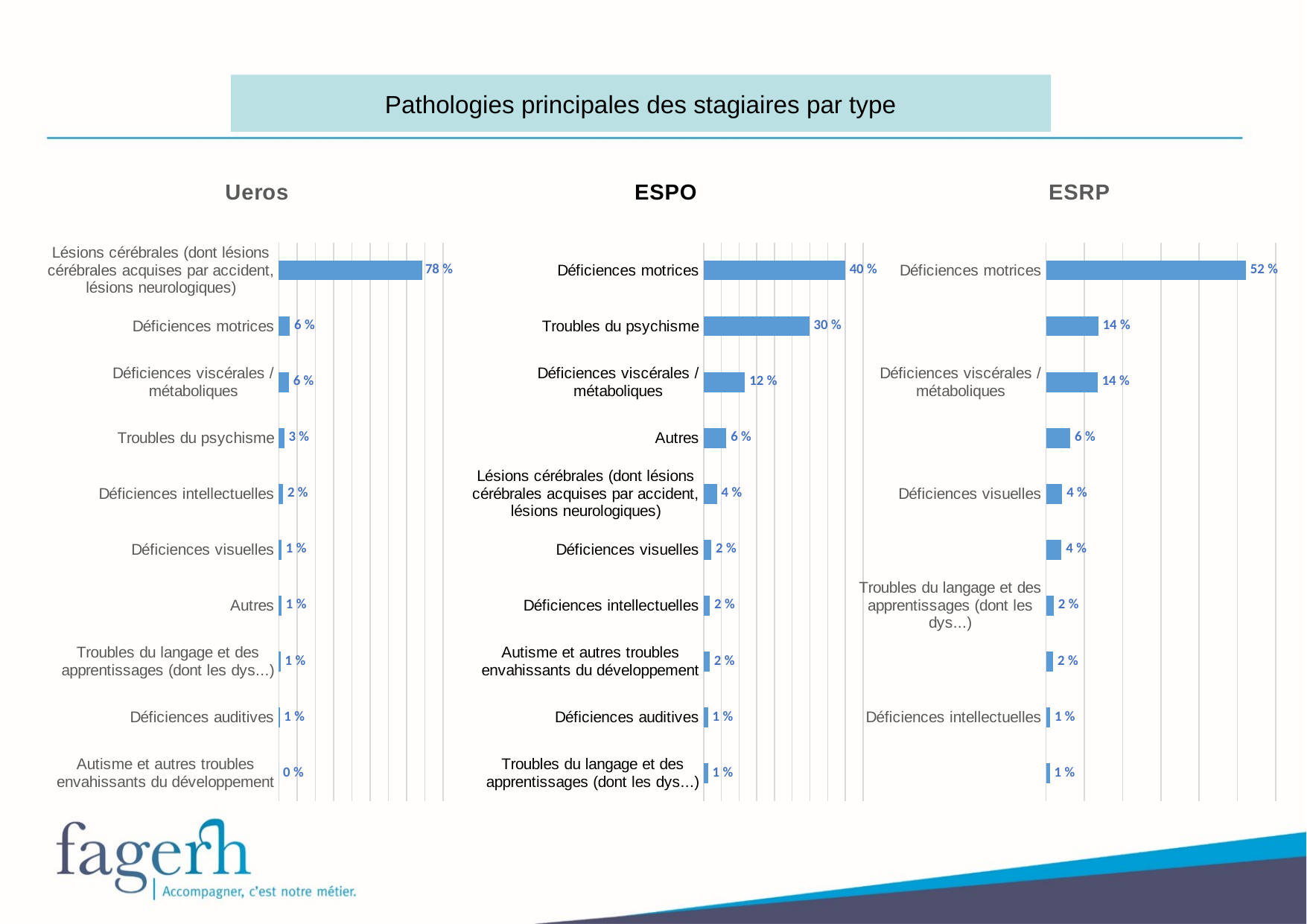
In the ESPO chart, which is larger: Déficiences viscérales / métaboliques or Autres? Déficiences viscérales / métaboliques In the ESPO chart, what is the difference between Déficiences motrices and Troubles du psychisme? 10 % In the ESPO chart, what is the value for Troubles du psychisme? 30 % In the ESRP chart, what is the value for Déficiences intellectuelles? 1 % In the Ueros chart, what is the value for Autisme et autres troubles envahissants du développement? 0 % In the Ueros chart, what is the value for Déficiences motrices? 6 % In the Ueros chart, which category has the highest value? Lésions cérébrales (dont lésions cérébrales acquises par accident, lésions neurologiques) In the ESRP chart, what is the value for Déficiences viscérales / métaboliques? 14 % In the ESRP chart, what is the value for Déficiences motrices? 52 % How many categories are plotted in the ESPO chart? 10 What is the title of the slide? Pathologies principales des stagiaires par type What type of chart is the Ueros chart? Bar chart